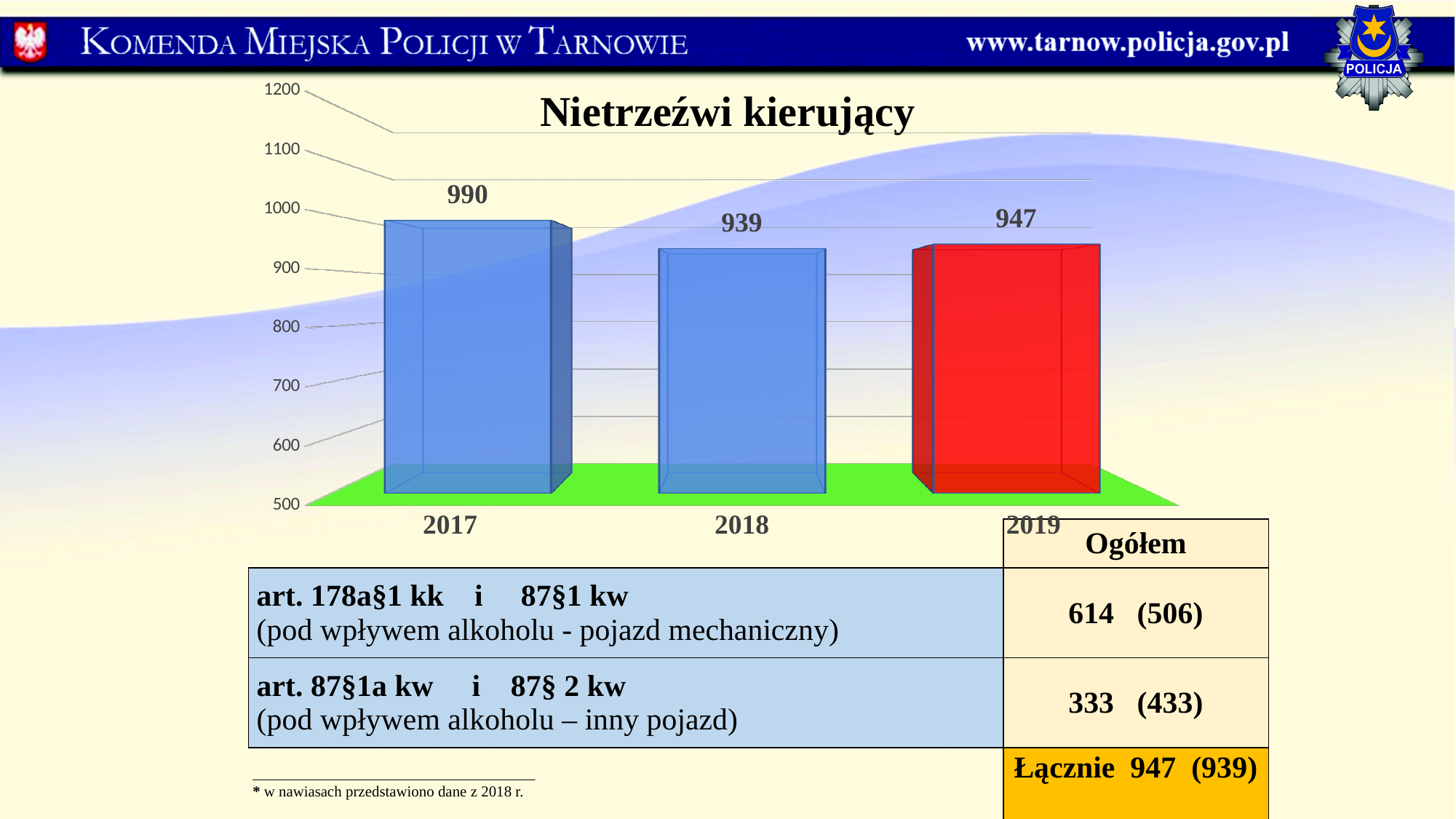
What is the difference between the values for 2017 and 2018? 51 Is the value for 2018 greater or less than 1000? less What kind of chart is shown on the slide? bar chart Which year has the highest value in the chart? 2017 How many years are shown in the chart? 3 Which year has the lowest value in the chart? 2018 What is the title of the chart? Nietrzeźwi kierujący What is the value for 2017 in the chart? 990 What is the value for 2018 in the chart? 939 What is the difference between the values for 2019 and 2018? 8 Which is larger, the value for 2017 or the value for 2019? 2017 What is the value for 2019 in the chart? 947